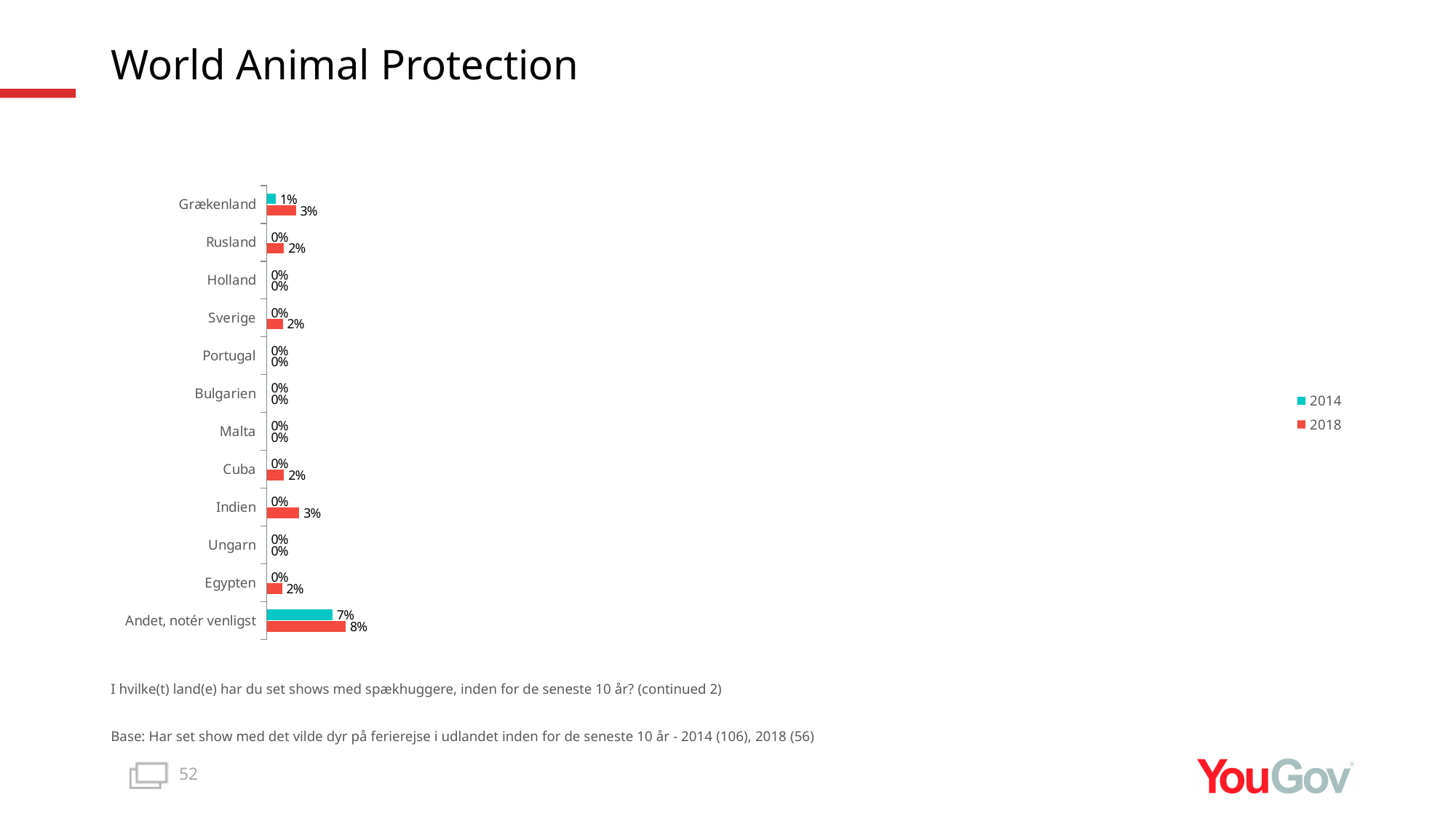
Which is larger for Indien: the 2014 value or the 2018 value? 2018 Which category has the highest 2014 value? Andet, notér venligst What is the difference between the 2018 and 2014 values for Grækenland? 2% How many series does the legend list? 2 What is the difference between the 2018 and 2014 values for Andet, notér venligst? 1% What kind of chart is shown on the slide? Bar chart What is the 2018 value for Indien? 3% What is the 2014 value for Andet, notér venligst? 7% What is the 2018 value for Grækenland? 3% How many categories are shown on the chart? 12 Which category has the highest 2018 value? Andet, notér venligst What is the 2018 value for Cuba? 2%